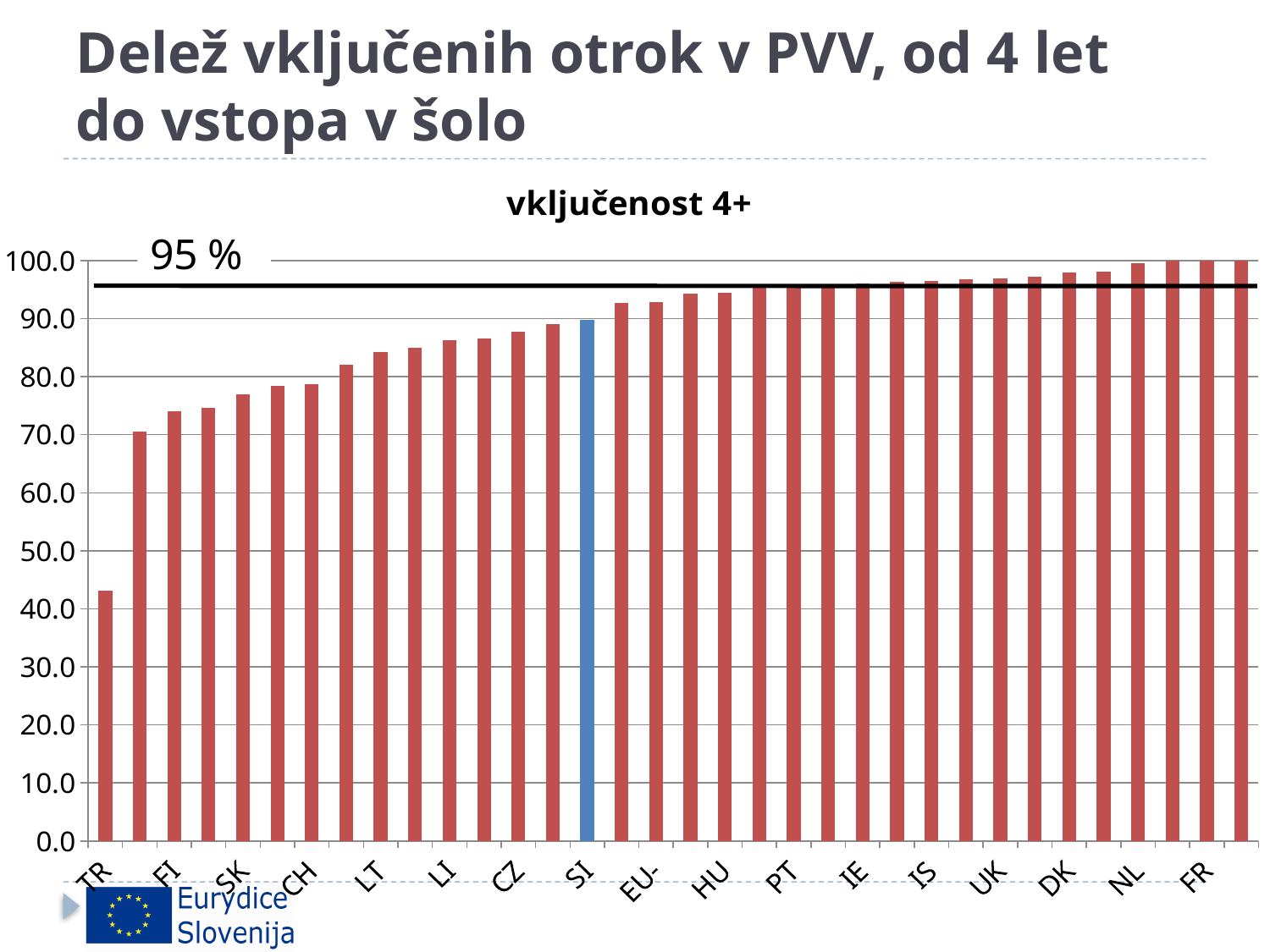
Which category has the lowest value? TR What is the title of the chart? vključenost 4+ Is the value for SK greater or less than 80? less Which is larger, the value for TR or the value for FI? FI Is the value for FR greater or less than 95? greater What kind of chart is shown on the slide? bar chart Is the value for CZ greater or less than 80? greater What value does the horizontal black line across the chart mark? 95 % Do the values generally rise or fall from left to right along the x axis? rise